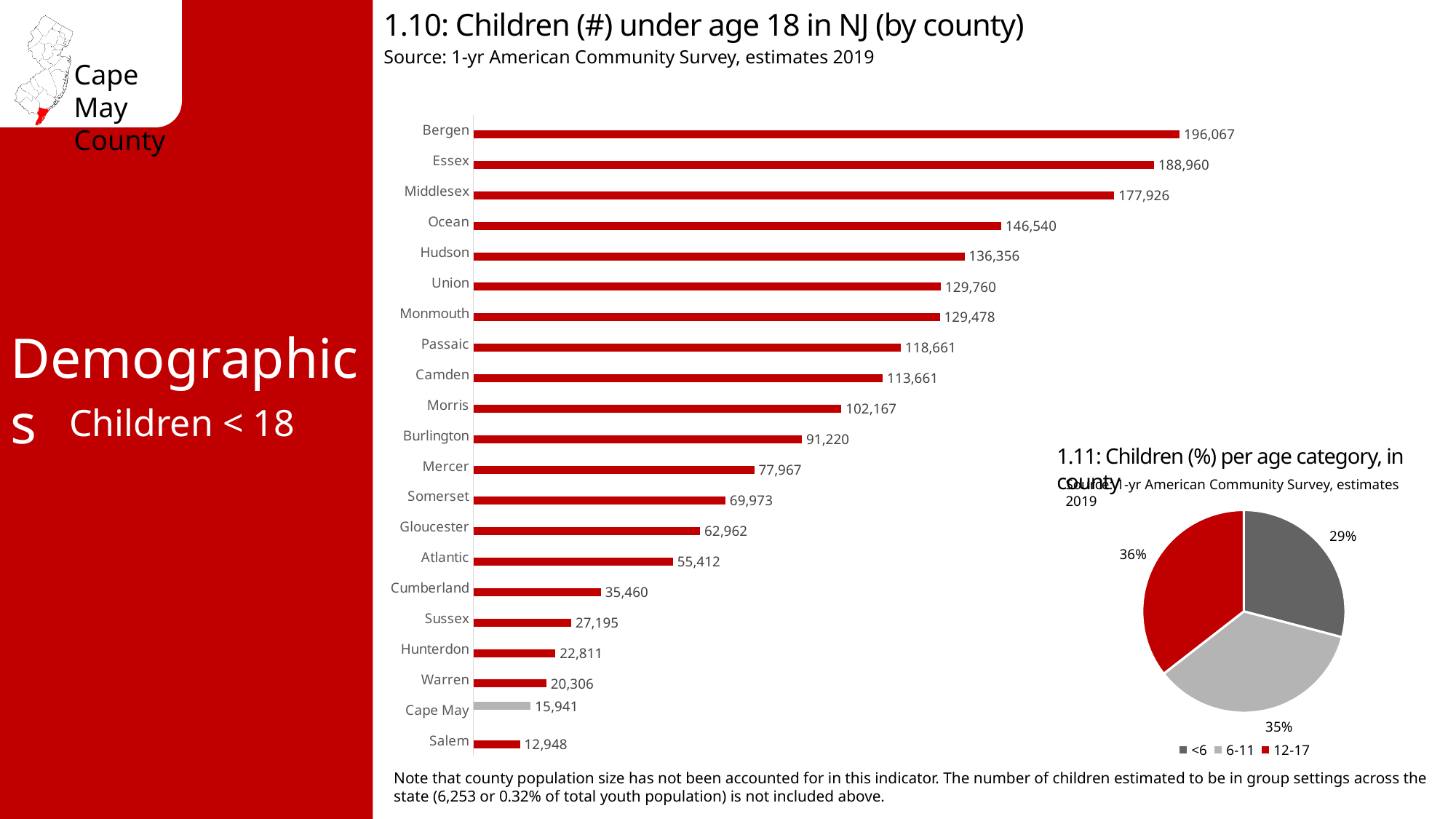
How many age categories does the legend of the pie chart '1.11: Children (%) per age category, in county' list? 3 In the chart '1.10: Children (#) under age 18 in NJ (by county)', how many children under 18 are in Bergen county? 196,067 In the chart '1.10: Children (#) under age 18 in NJ (by county)', which county has the lowest number of children under 18? Salem What type of chart is '1.10: Children (#) under age 18 in NJ (by county)'? Bar chart In the chart '1.10: Children (#) under age 18 in NJ (by county)', which county has the highest number of children under 18? Bergen In the pie chart '1.11: Children (%) per age category, in county', what share of children are in the 6-11 age category? 35% How many counties are shown in the chart '1.10: Children (#) under age 18 in NJ (by county)'? 21 In the chart '1.10: Children (#) under age 18 in NJ (by county)', what is the value for Cape May? 15,941 In the pie chart '1.11: Children (%) per age category, in county', which age category has the largest share? 12-17 In the chart '1.10: Children (#) under age 18 in NJ (by county)', which county has more children under 18, Ocean or Hudson? Ocean In the chart '1.10: Children (#) under age 18 in NJ (by county)', which county's bar is coloured grey instead of red? Cape May In the chart '1.10: Children (#) under age 18 in NJ (by county)', what is the difference between the values for Essex and Middlesex? 11,034